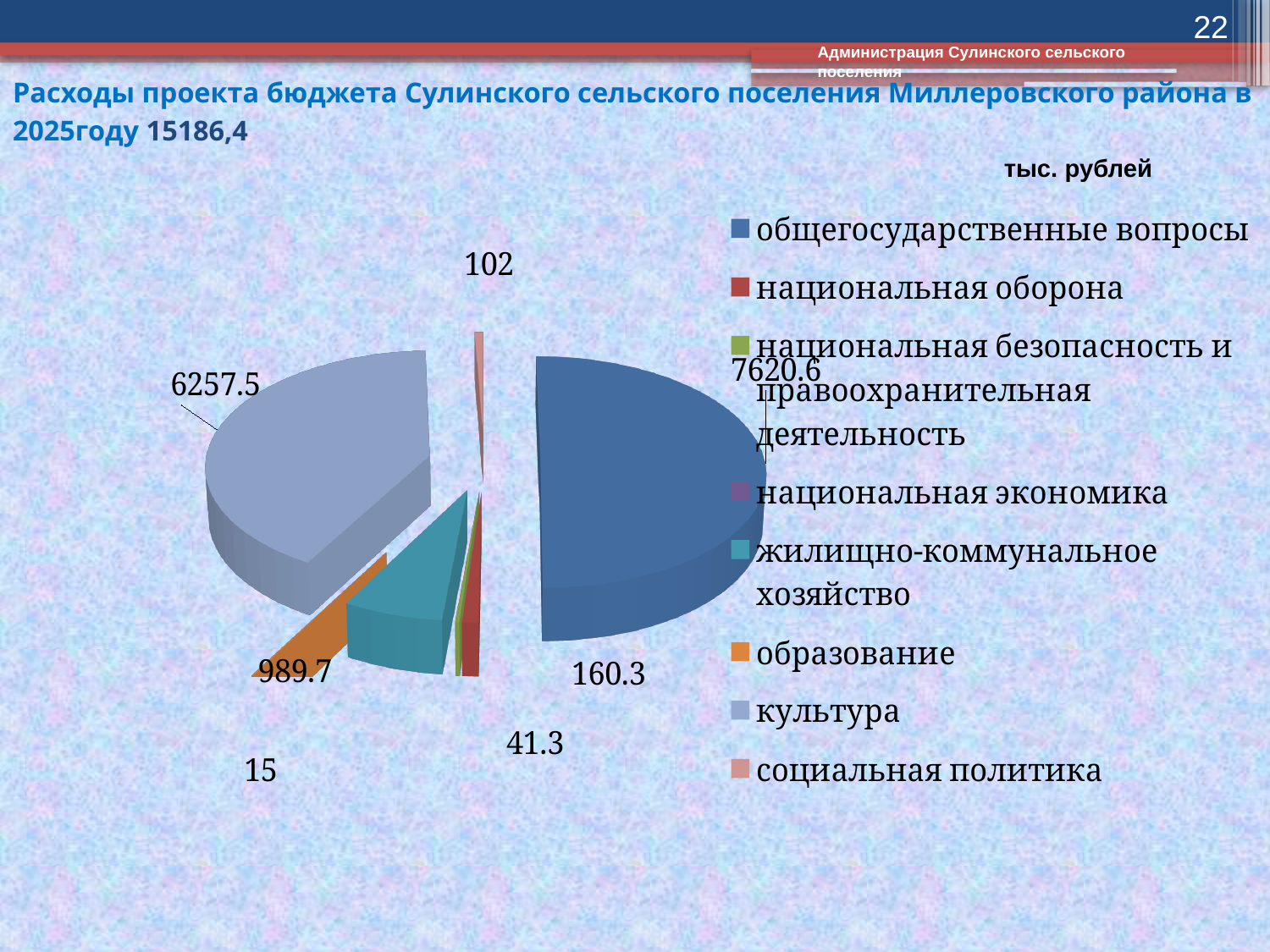
What is the difference between the values for общегосударственные вопросы and культура? 1363.1 Which category has the largest slice of the pie? общегосударственные вопросы What is the value for национальная безопасность и правоохранительная деятельность? 41.3 In what units are the values on the chart given? тыс. рублей Which is larger, the value for культура or the value for жилищно-коммунальное хозяйство? культура What is the value for национальная оборона? 160.3 What is the value for культура? 6257.5 What is the value for жилищно-коммунальное хозяйство? 989.7 How many categories does the legend of the pie chart list? 8 What is the value for социальная политика? 102 What kind of chart is shown on the slide? pie chart What is the value for общегосударственные вопросы? 7620.6